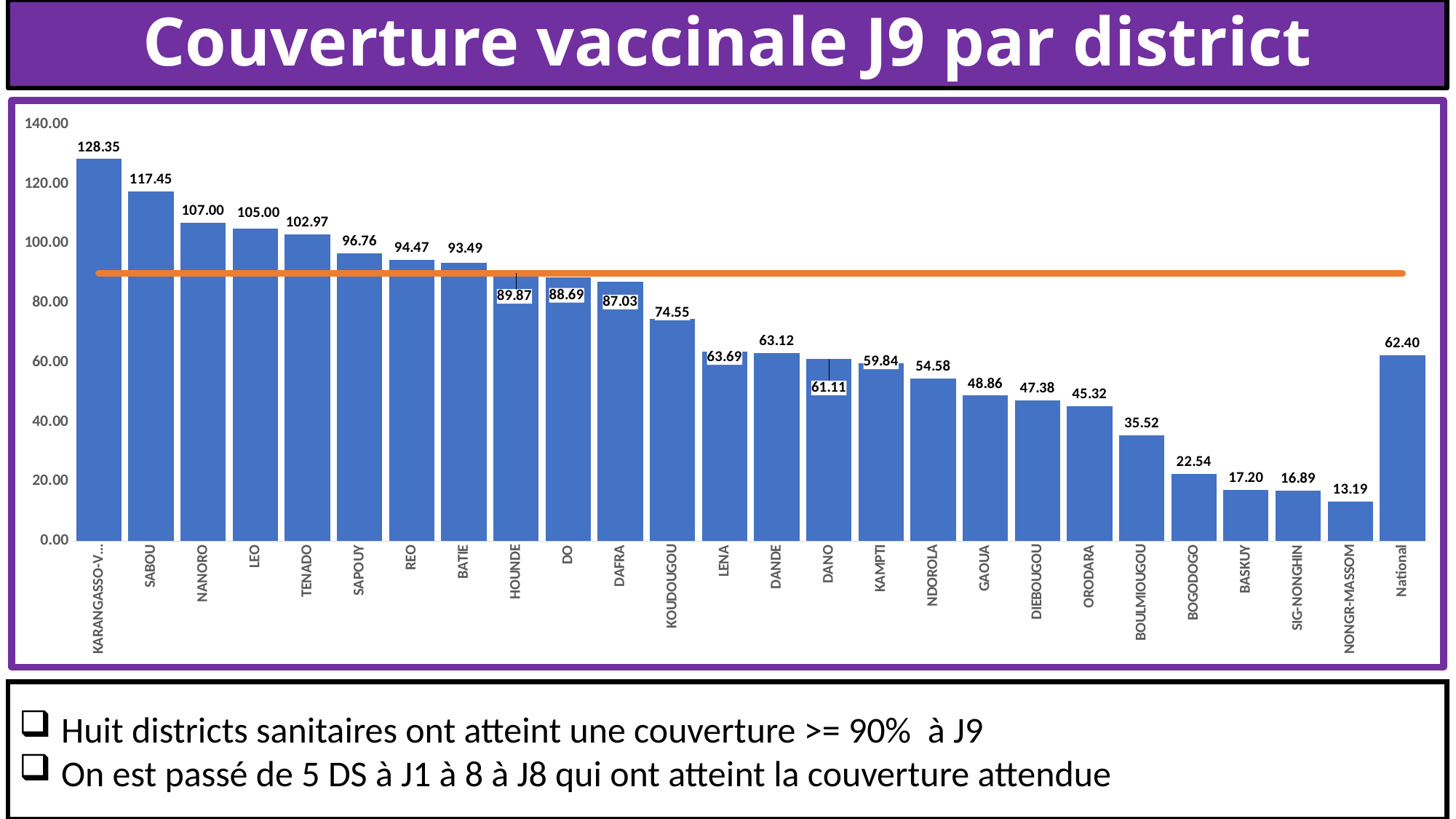
Which is larger, the value for GAOUA or the value for ORODARA? GAOUA What kind of chart is shown on the slide? bar chart What is the difference between the values for DANDE and DANO? 2.01 Which district has the lowest value? NONGR-MASSOM What is the value for KOUDOUGOU? 74.55 What is the value for National? 62.40 Is the value for HOUNDE greater or less than 100? less How many bars are shown in the chart? 26 What is the value for BOULMIOUGOU? 35.52 What is the difference between the values for NANORO and LEO? 2.00 What is the value for SABOU? 117.45 What is the title of the slide? Couverture vaccinale J9 par district